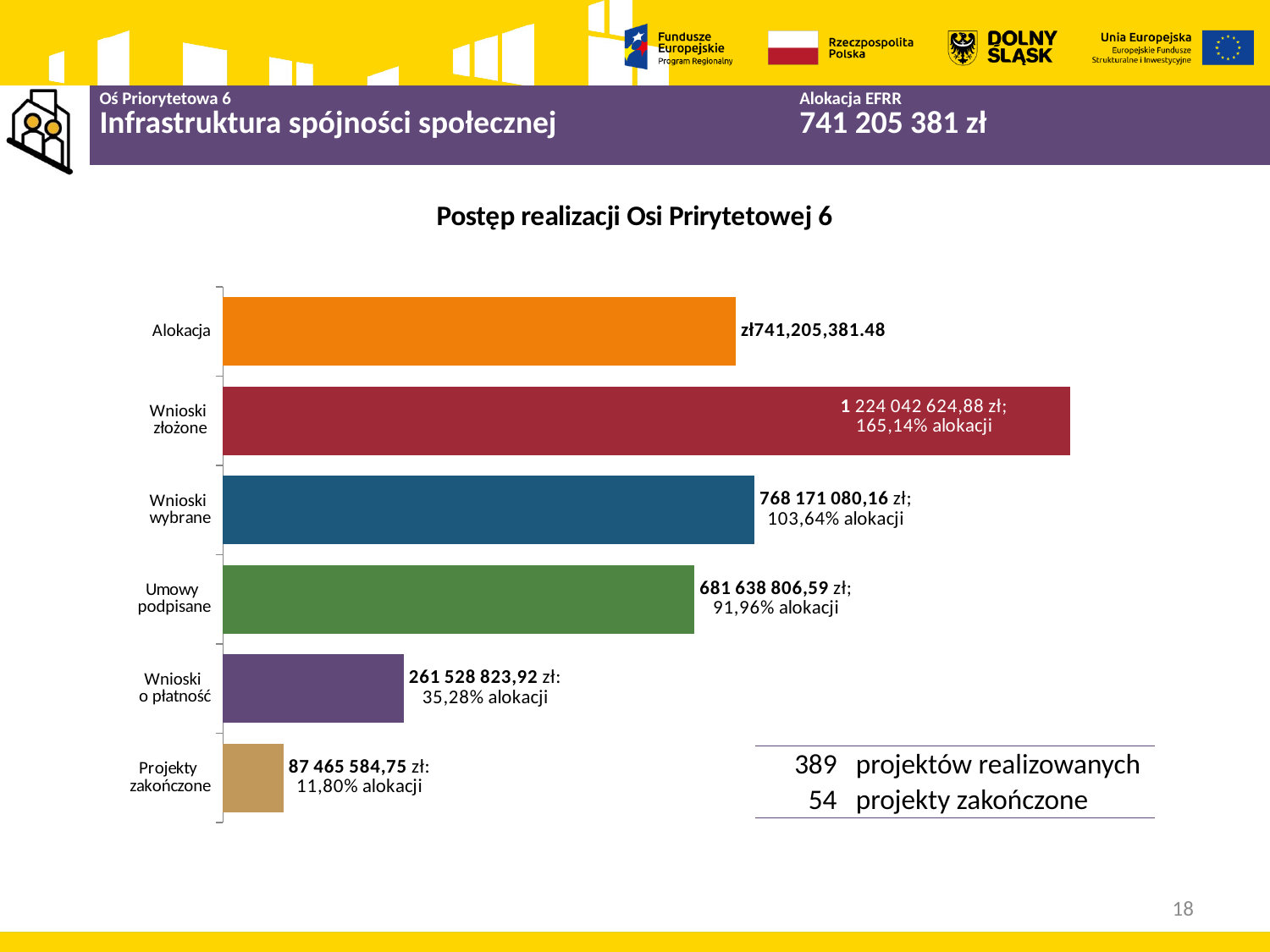
What percentage of the allocation do Umowy podpisane represent? 91,96% What is the value shown for Projekty zakończone? 87 465 584,75 zł What is the title of the chart? Postęp realizacji Osi Prirytetowej 6 What colour is the bar for Alokacja? orange What kind of chart is shown on the slide? bar chart How many categories does the chart show? 6 What is the value shown for Wnioski złożone? 1 224 042 624,88 zł Which category has the lowest value? Projekty zakończone Which is larger, Umowy podpisane or Wnioski o płatność? Umowy podpisane What is the difference between the values for Wnioski wybrane and Umowy podpisane? 86 532 273,57 zł What is the value shown for Alokacja? zł741,205,381.48 Which category has the highest value? Wnioski złożone